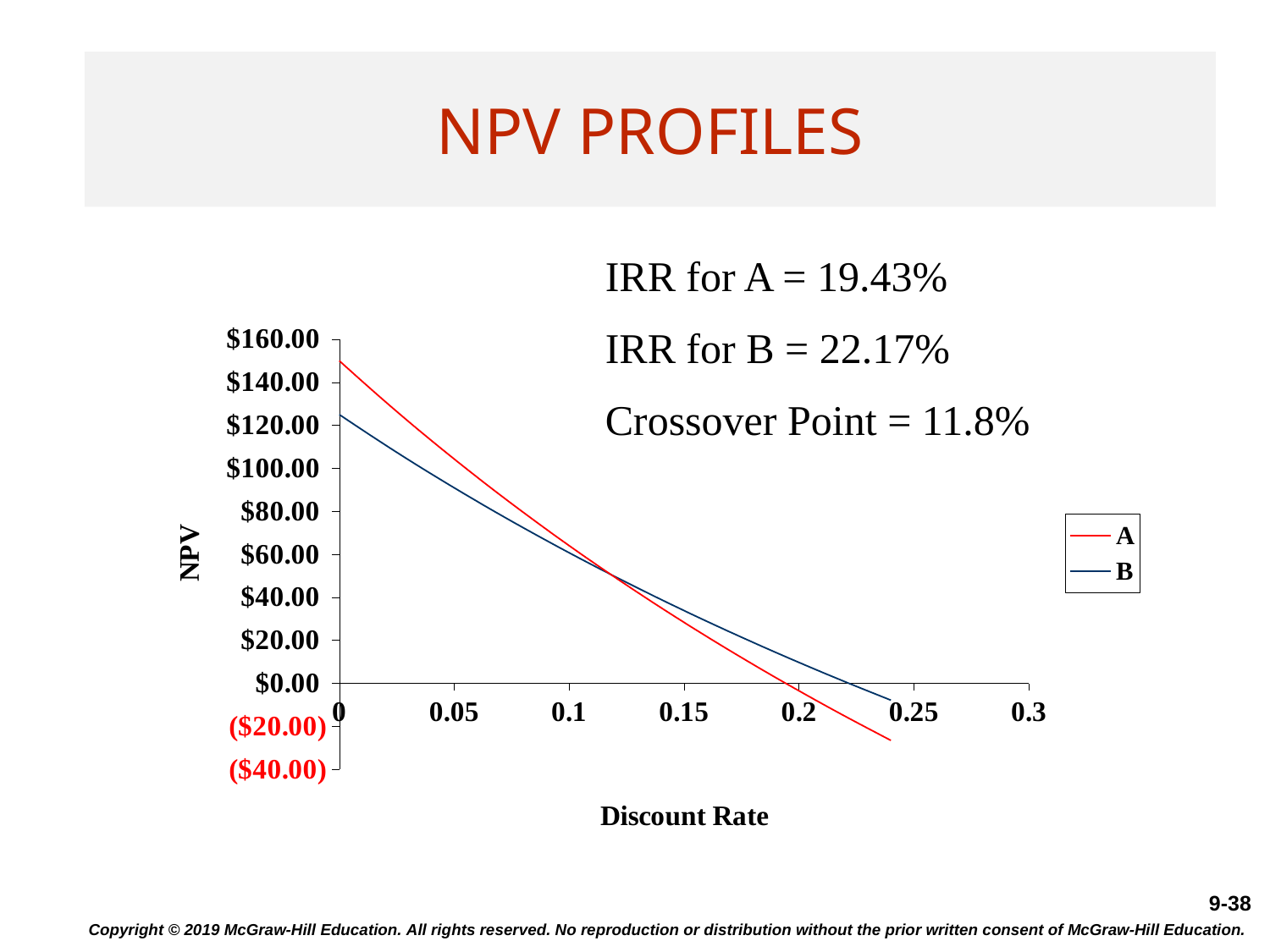
Is the NPV for series B at a discount rate of 0 greater or less than $100.00? greater Is the NPV for series A at a discount rate of 0 greater or less than $120.00? greater At a discount rate of 0, which series has the higher NPV, A or B? A Is the NPV for series A at a discount rate of 0.15 greater or less than $60.00? less How many series does the chart legend list? 2 What colour is the line for series A in the chart? red At a discount rate of 0.2, which series has the higher NPV, A or B? B Do the NPV values for series A rise or fall as the discount rate increases? fall Do the NPV values for series B rise or fall as the discount rate increases? fall What is the label on the horizontal axis of the chart? Discount Rate What kind of chart is shown on the slide? line chart